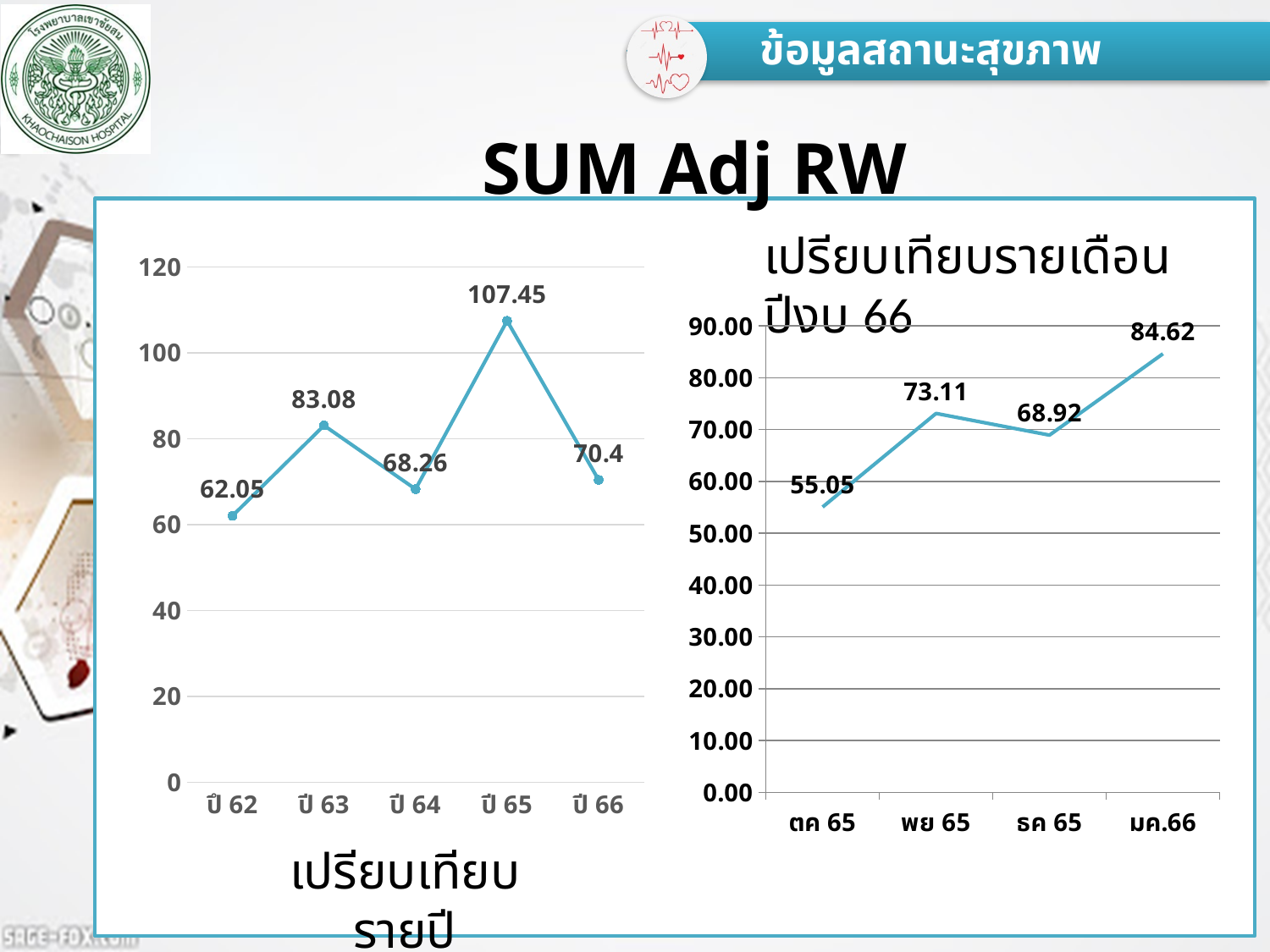
On the left chart (yearly comparison), what is the difference between the values for ปี 63 and ปี 64? 14.82 On the right chart (monthly comparison, fiscal year 66), which month has the highest value? มค.66 On the left chart (yearly comparison), how many years are plotted? 5 On the right chart (monthly comparison, fiscal year 66), what is the difference between the values for มค.66 and ตค 65? 29.57 On the right chart (monthly comparison, fiscal year 66), which is larger, the value for พย 65 or ธค 65? พย 65 On the left chart (yearly comparison), which year has the highest value? ปี 65 On the left chart (yearly comparison), what is the value for ปี 62? 62.05 On the right chart (monthly comparison, fiscal year 66), what is the value for พย 65? 73.11 On the right chart (monthly comparison, fiscal year 66), which month has the lowest value? ตค 65 On the left chart (yearly comparison), what is the value for ปี 65? 107.45 What kind of chart is the right chart (monthly comparison, fiscal year 66)? Line chart On the left chart (yearly comparison), which year has the lowest value? ปี 62